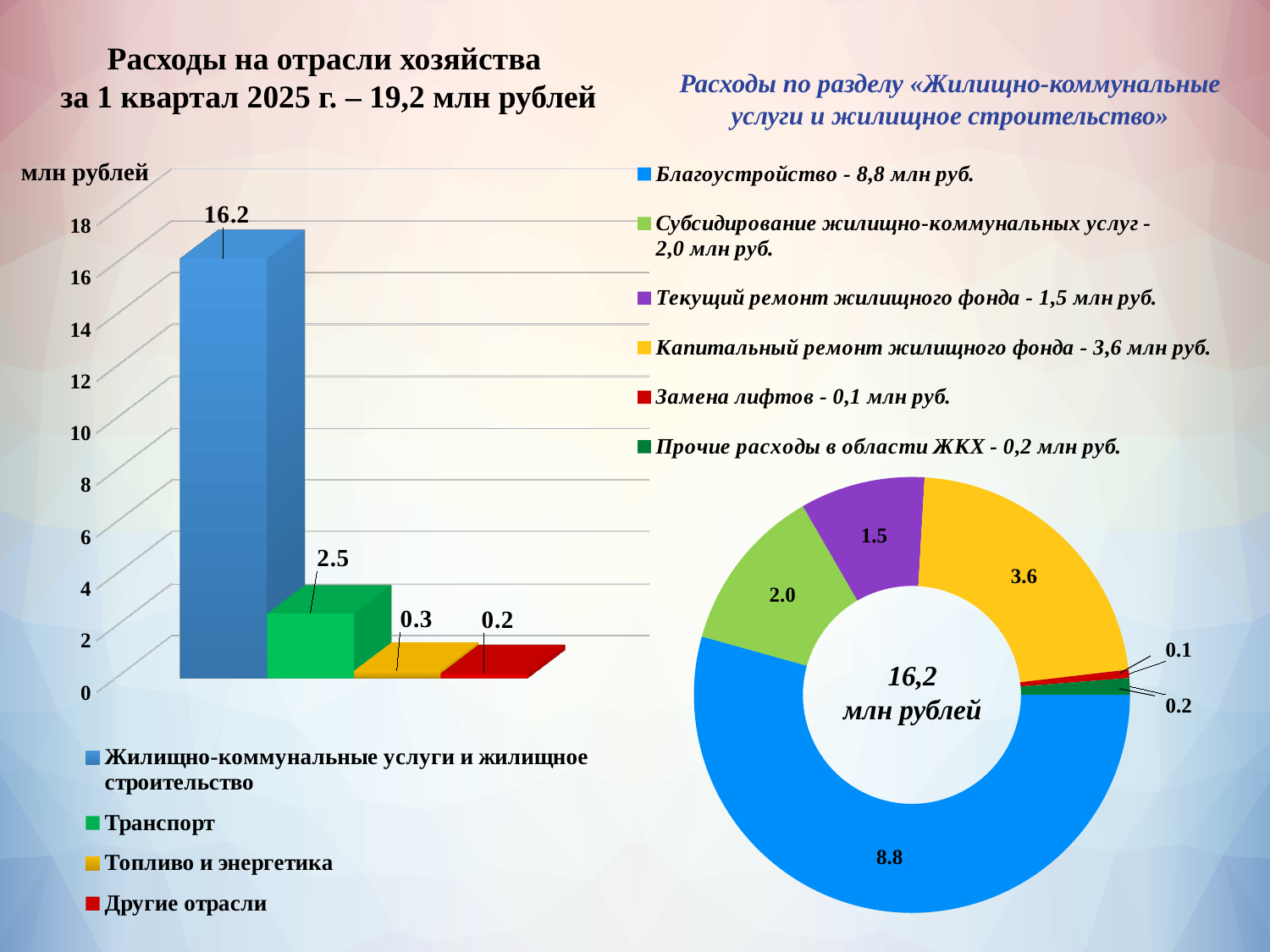
In the bar chart on the left, what is the value for Жилищно-коммунальные услуги и жилищное строительство? 16.2 In the bar chart on the left, what is the difference between the values for Жилищно-коммунальные услуги и жилищное строительство and Транспорт? 13.7 In the doughnut chart on the right, which is larger: Субсидирование жилищно-коммунальных услуг or Текущий ремонт жилищного фонда? Субсидирование жилищно-коммунальных услуг In the bar chart on the left, what is the value for Транспорт? 2.5 In the doughnut chart on the right, what is the value for Капитальный ремонт жилищного фонда? 3.6 In the doughnut chart on the right, which category has the largest value? Благоустройство In the doughnut chart on the right, how many categories does the legend list? 6 In the bar chart on the left, which category has the lowest value? Другие отрасли In the bar chart on the left, is the value for Топливо и энергетика greater or less than 2? less What total is printed in the centre of the doughnut chart on the right? 16,2 млн рублей In the bar chart on the left, how many categories are plotted? 4 What kind of chart is shown on the left side of the slide? bar chart